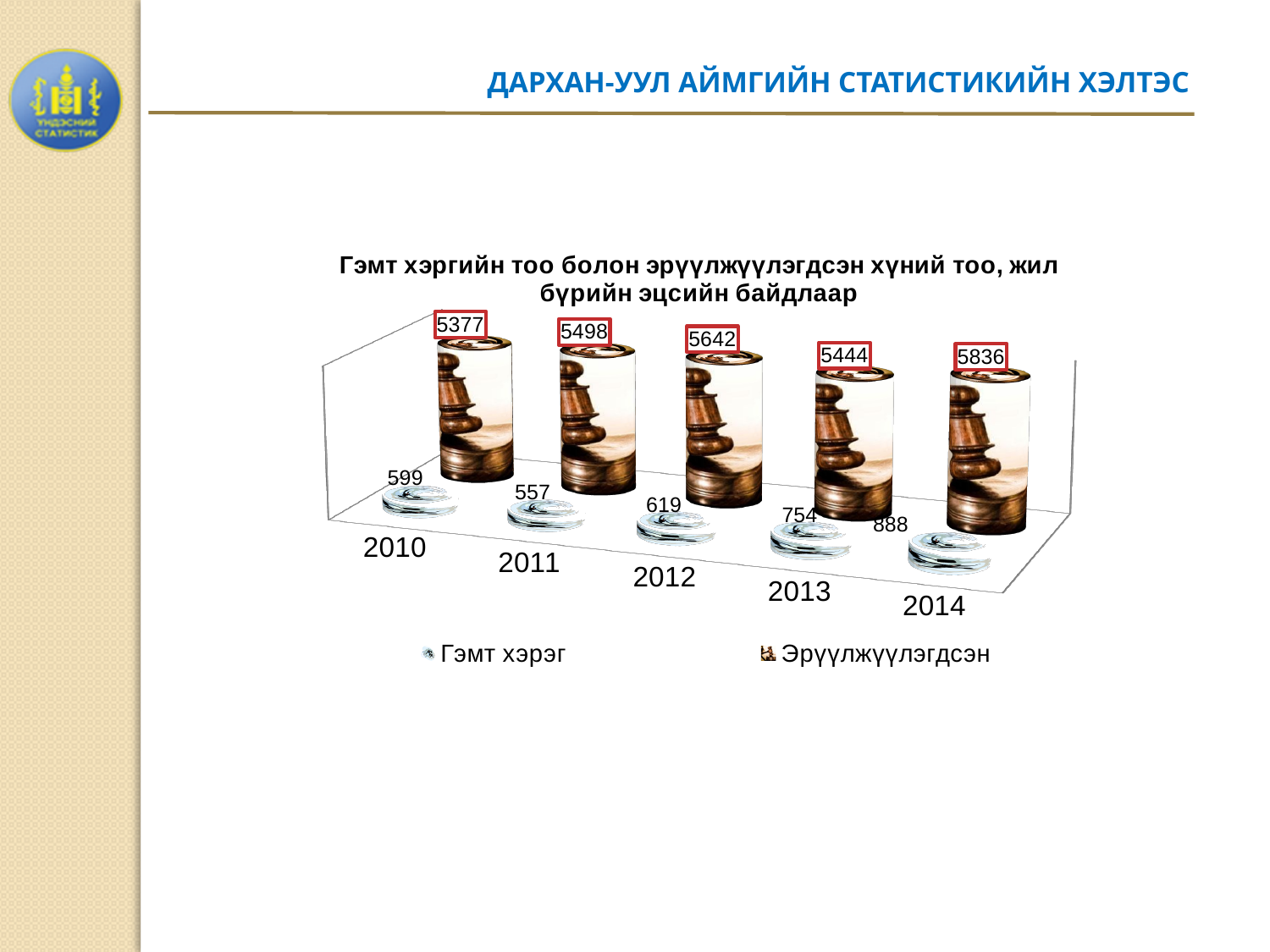
What is the difference between the Эрүүлжүүлэгдсэн values for 2014 and 2010? 459 What is the difference between the Гэмт хэрэг values for 2014 and 2013? 134 What is the value for Гэмт хэрэг in 2011? 557 In which year is the Гэмт хэрэг value lowest? 2011 How many years are shown on the x axis? 5 What is the value for Гэмт хэрэг in 2014? 888 In which year is the Эрүүлжүүлэгдсэн value highest? 2014 Does the Гэмт хэрэг value rise or fall from 2011 to 2014? rise What kind of chart is shown on the slide? bar chart Which is larger, the Эрүүлжүүлэгдсэн value for 2012 or for 2013? 2012 What is the value for Эрүүлжүүлэгдсэн in 2012? 5642 How many series does the legend list? 2